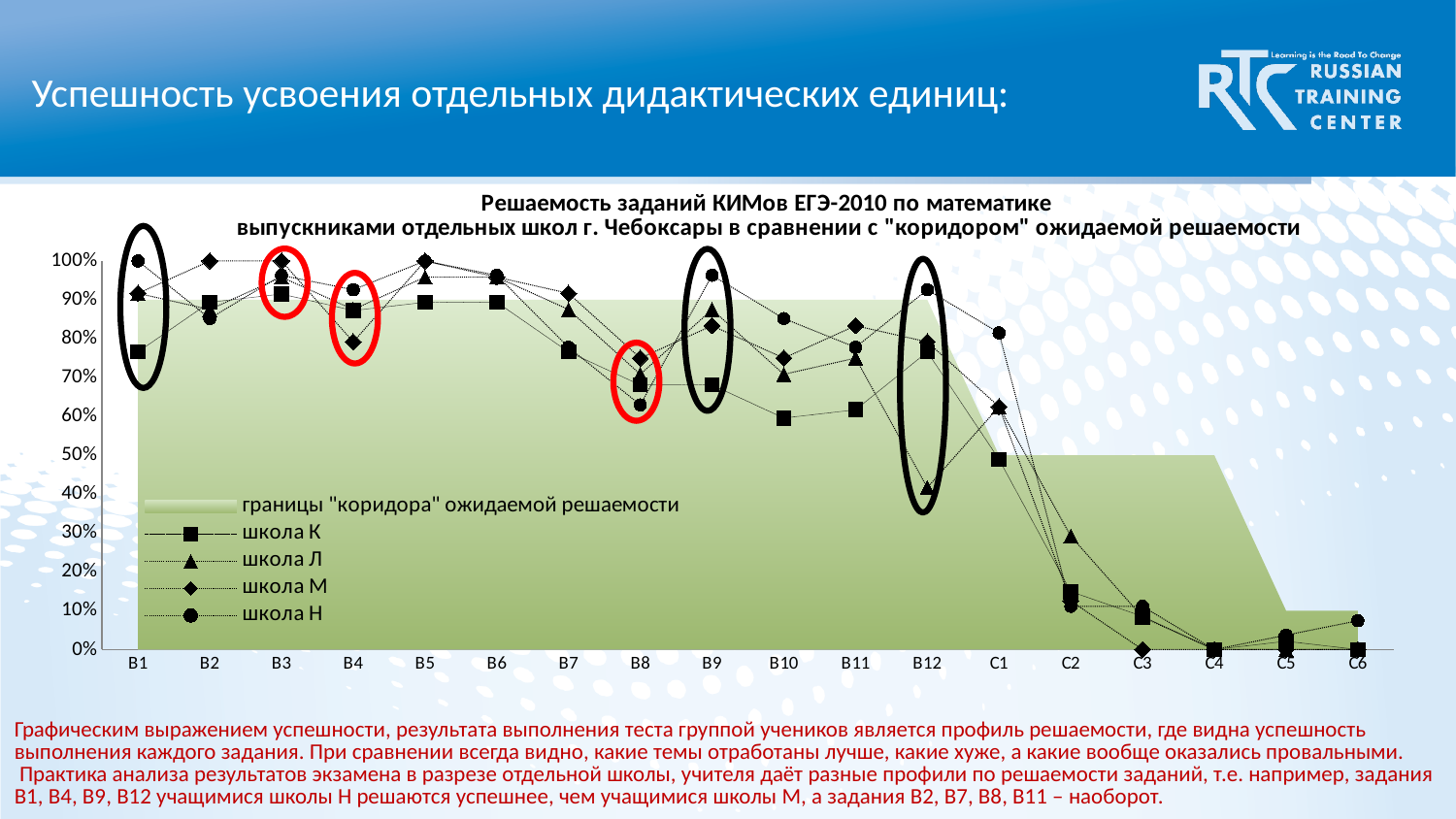
What kind of chart is shown on the slide? line chart Is the value for школа Н at B1 greater or less than 90%? greater Is the value for школа Л at B12 greater or less than 50%? less Do the schools' values generally rise or fall moving from B1 to C6 along the x axis? fall Is the value for школа К at B1 greater or less than 50%? greater How many task categories are shown along the x axis? 18 How many entries does the legend list? 5 At B12, which school has the larger value, школа Н or школа Л? школа Н Which school has the highest value at B1? школа Н